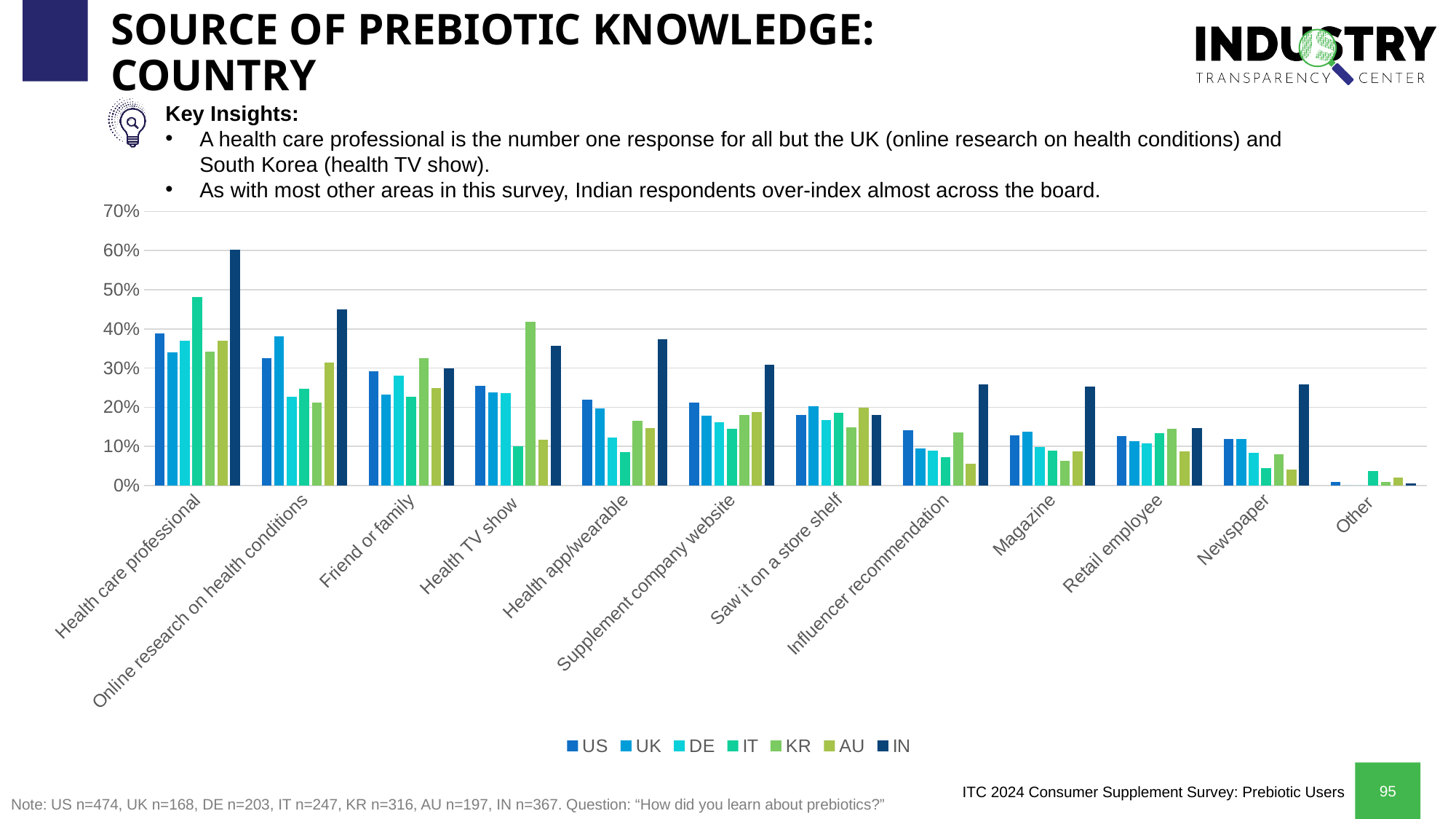
Which country has the highest value for Health TV show? KR For Online research on health conditions, which is larger: the value for UK or the value for US? UK Do the values for US generally rise or fall moving from left to right across the categories? fall Is the value for IN under Health care professional greater or less than 50%? greater Which country has the highest value for Health care professional? IN How many series does the legend list? 7 How many source categories are shown along the x axis? 12 Is the value for IN under Health app/wearable greater or less than 30%? greater Is the value for KR under Health care professional greater or less than 40%? less What kind of chart is shown on the slide? bar chart Which series is shown in the darkest navy colour in the legend? IN Which country has the lowest value for Health app/wearable? IT